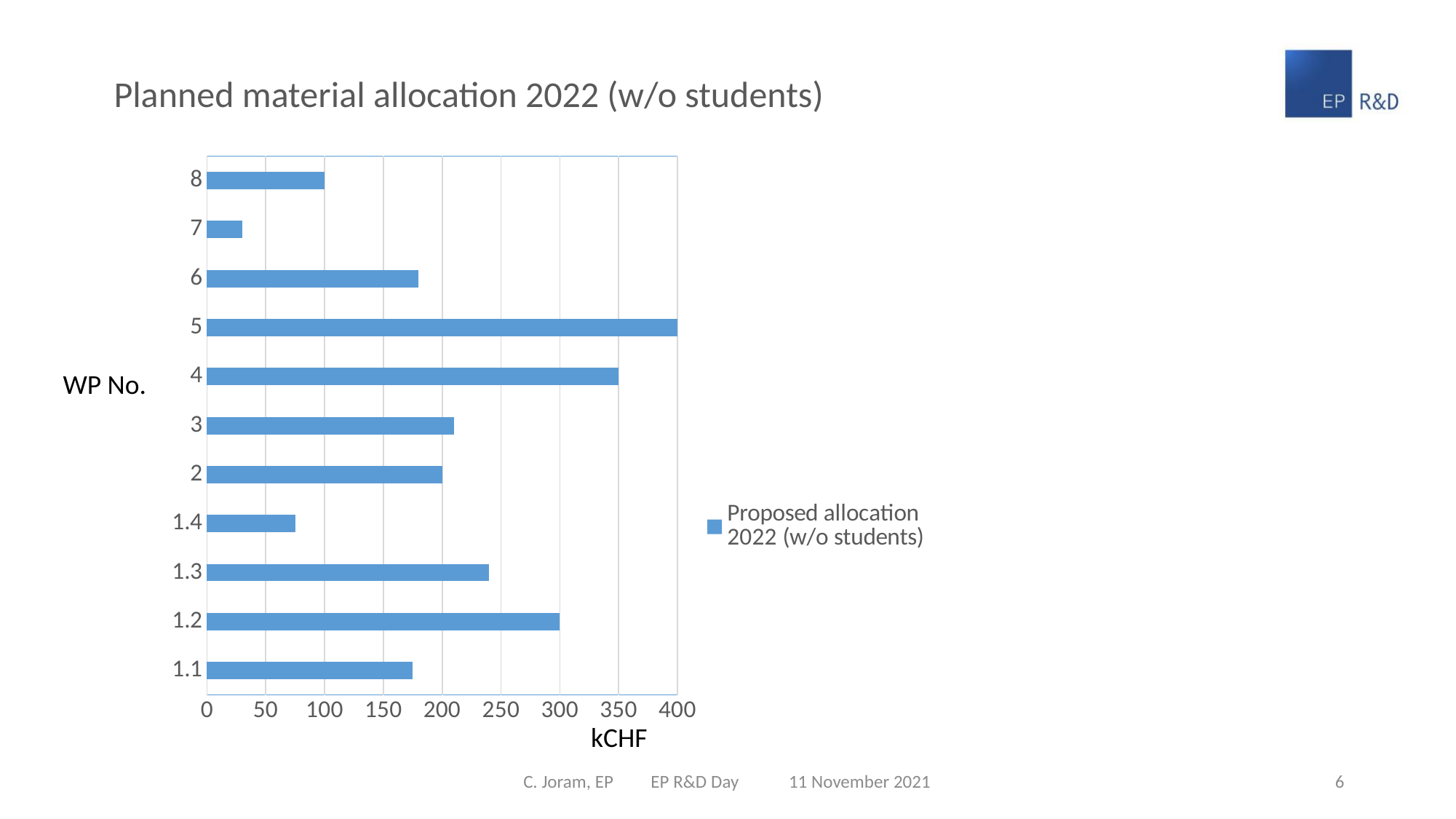
How many series does the legend list? 1 Is the value for WP 1.4 greater or less than 100? less Which WP No. has the highest proposed allocation? 5 What is the proposed allocation for WP 4, in kCHF? 350 What is the proposed allocation for WP 1.2, in kCHF? 300 Which has the larger proposed allocation, WP 4 or WP 1.2? WP 4 What is the label of the x axis? kCHF What kind of chart is shown on the slide? bar chart Which WP No. has the lowest proposed allocation? 7 How many work packages (categories) are plotted on the chart? 11